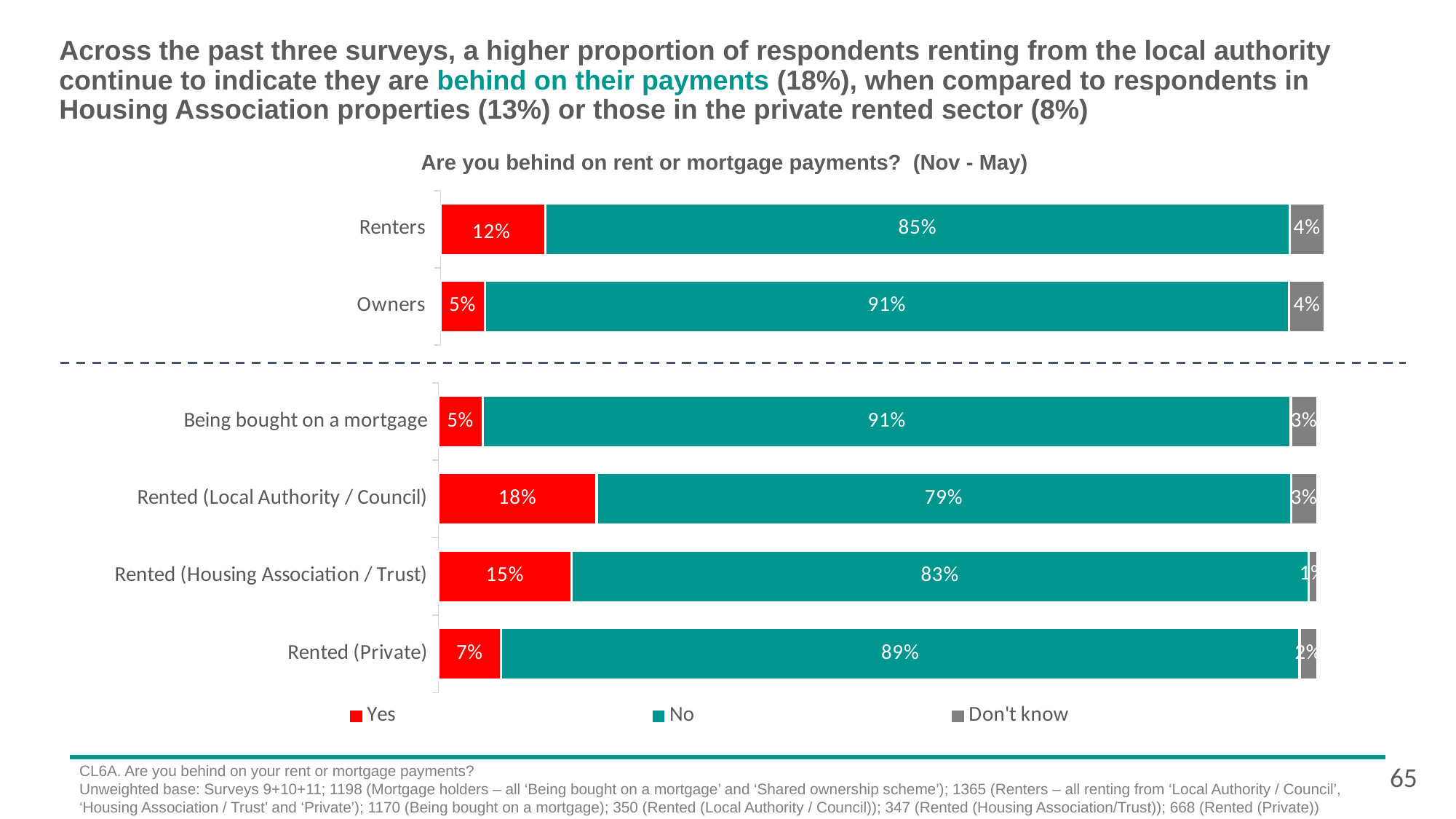
What is the total of the Owners stacked bar? 100% What is the No value for Rented (Housing Association / Trust)? 83% How many series does the legend list? 3 What is the No value for Renters? 85% What percentage of respondents in the Rented (Local Authority / Council) category answered Yes? 18% What kind of chart is shown on the slide? Stacked bar chart Among the four categories below the dashed line, which has the lowest Yes value? Being bought on a mortgage Which category has the highest Yes value? Rented (Local Authority / Council) What is the Don't know value for Owners? 4% Which has the larger No value, Owners or Renters? Owners How many categories are shown below the dashed line? 4 How many percentage points higher is the Yes value for Rented (Local Authority / Council) than for Rented (Private)? 11 percentage points